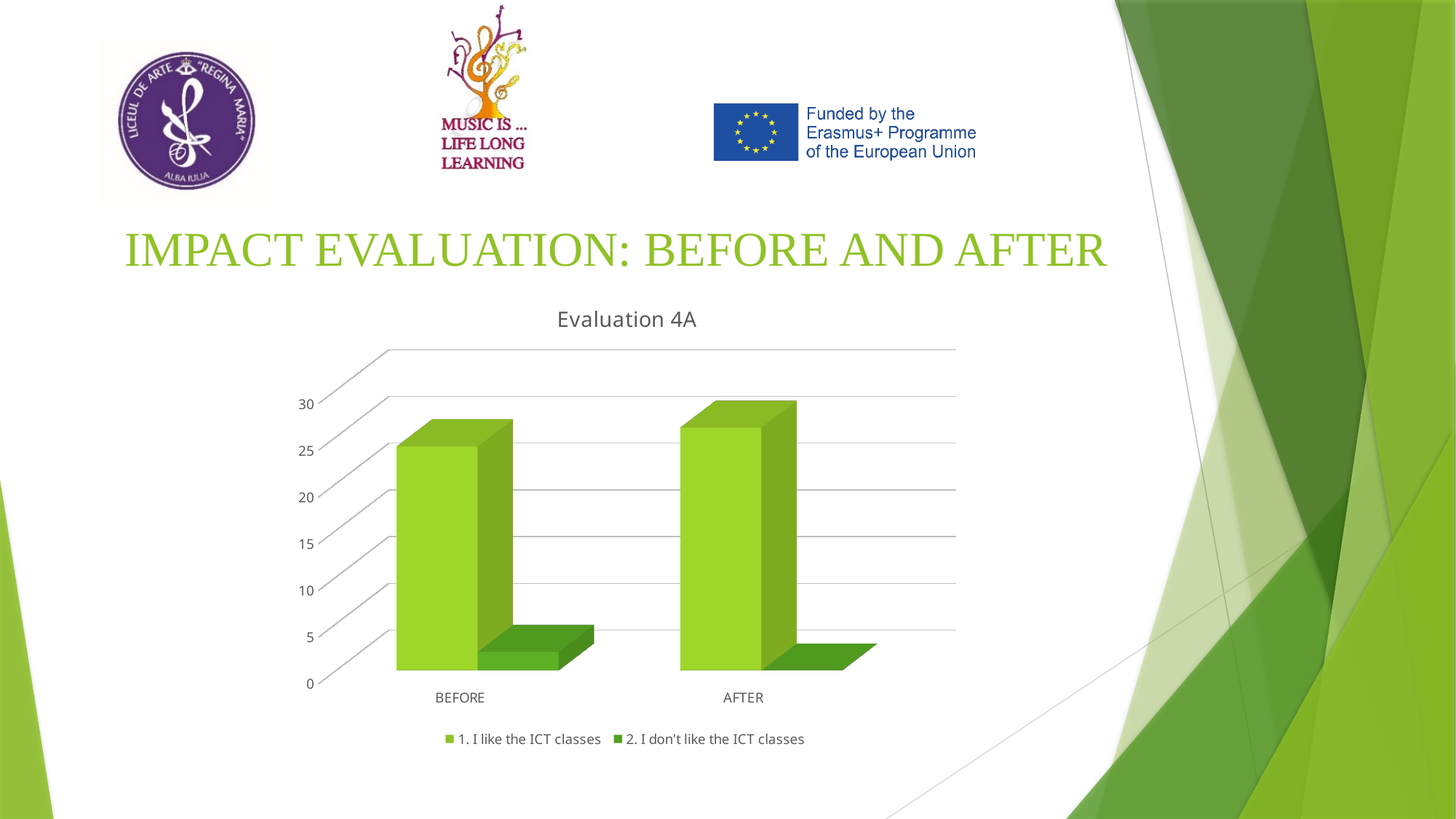
Is the value for '1. I like the ICT classes' at AFTER greater or less than 20? greater Does the value for '1. I like the ICT classes' rise or fall from BEFORE to AFTER? rise What is the title of the chart? Evaluation 4A At BEFORE, which series has the larger value: '1. I like the ICT classes' or '2. I don't like the ICT classes'? 1. I like the ICT classes Is the value for '2. I don't like the ICT classes' at AFTER greater or less than 5? less What kind of chart is shown on the slide? bar chart Is the value for '1. I like the ICT classes' at BEFORE greater or less than 20? greater Does the value for '2. I don't like the ICT classes' rise or fall from BEFORE to AFTER? fall How many categories are shown on the x axis? 2 How many series does the legend list? 2 What are the two categories on the x axis? BEFORE and AFTER